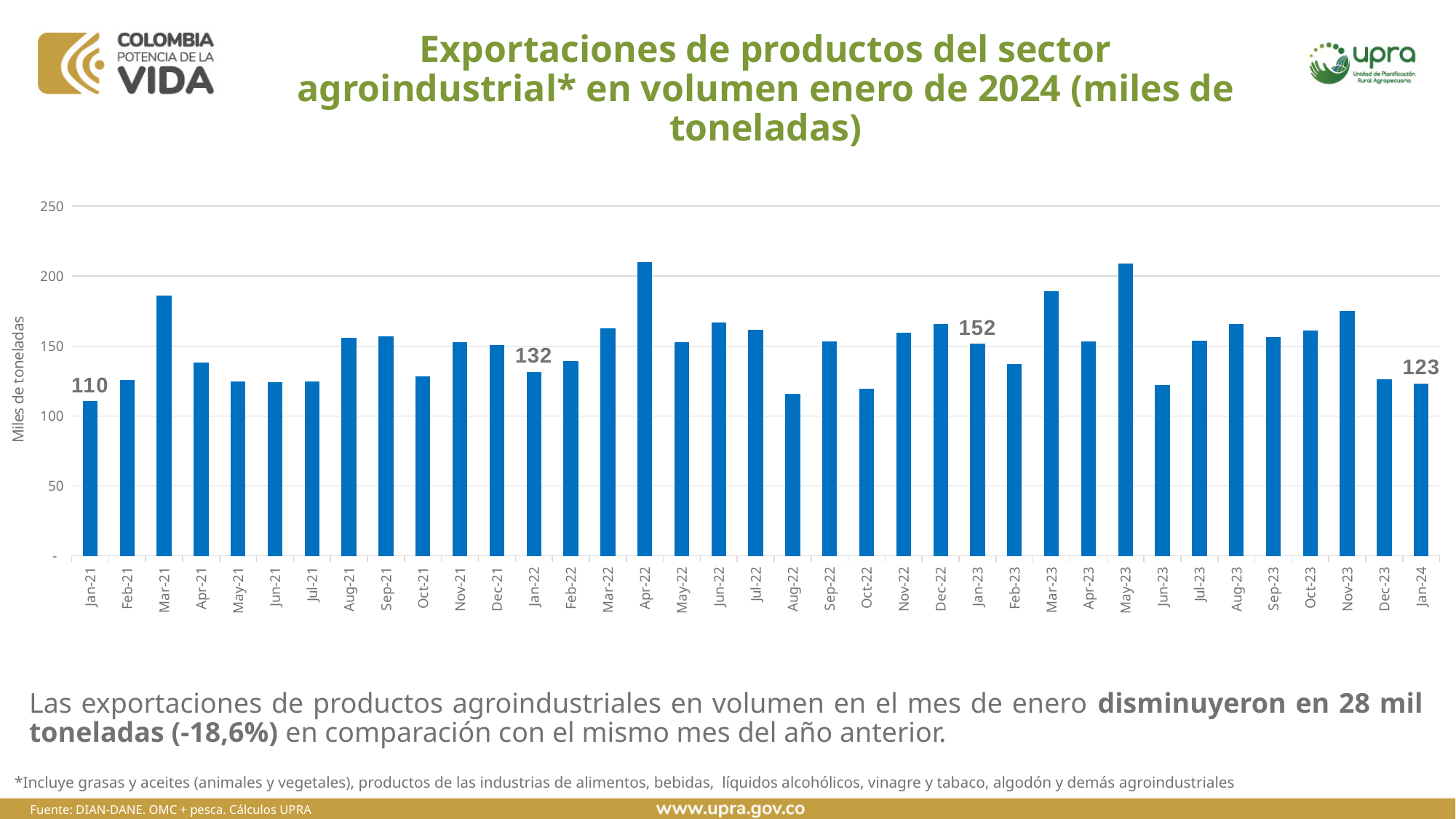
Is the value for Jun-23 greater or less than 150? less How many monthly bars are plotted in the chart? 37 What is the value for Jan-22? 132 What is the label on the vertical axis of the chart? Miles de toneladas What is the value for Jan-24? 123 What kind of chart is shown on the slide? bar chart What is the difference between the values for Jan-22 and Jan-21? 22 Which is larger, the value for Jan-23 or the value for Jan-24? Jan-23 What is the value for Jan-21? 110 What is the value for Jan-23? 152 Is the value for Apr-22 greater or less than 200? greater Which month has the lowest value in the chart? Jan-21